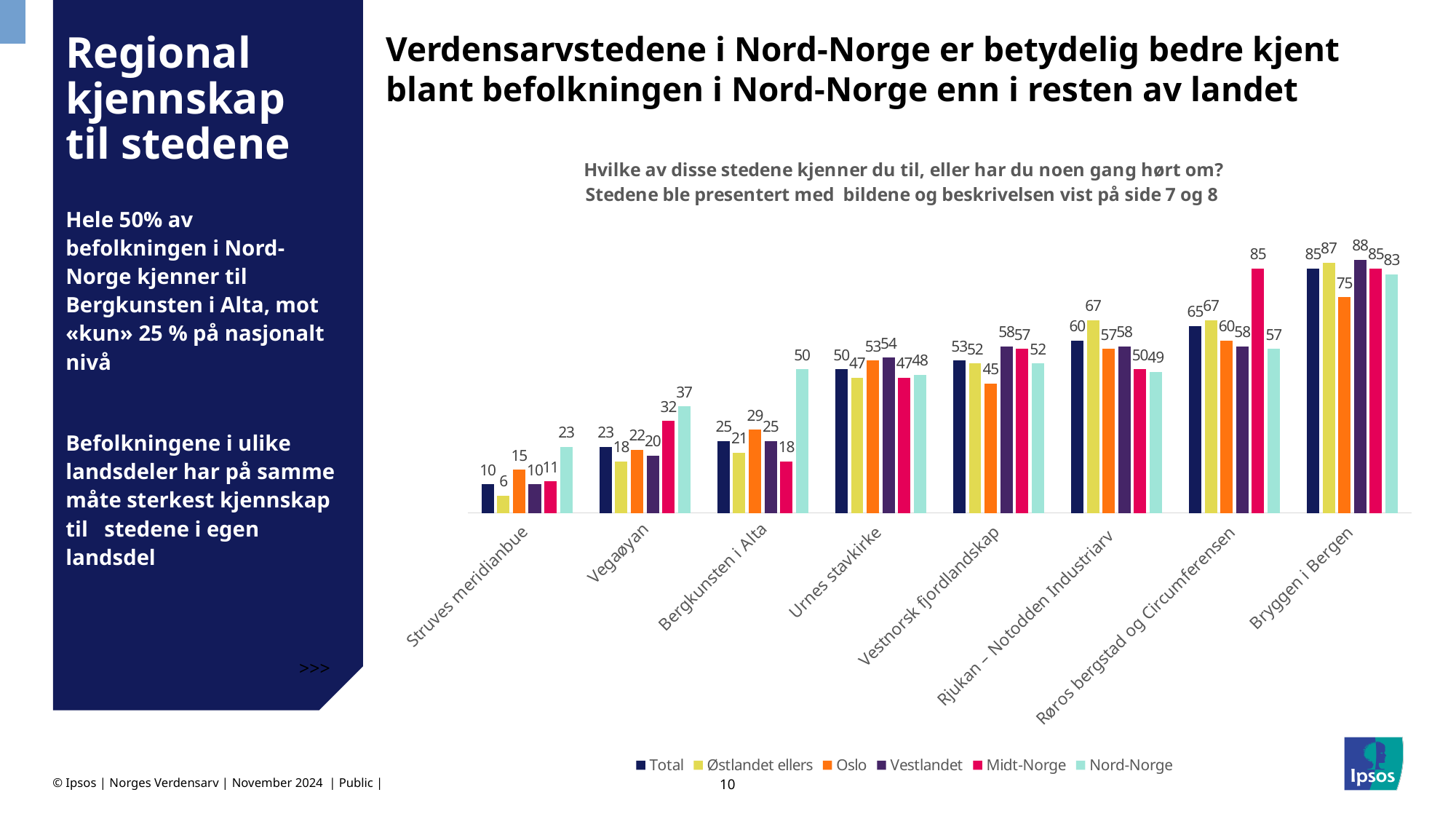
How many categories are shown on the x axis? 8 What is the Østlandet ellers value for Struves meridianbue? 6 What is the difference between the Nord-Norge and Total values for Bergkunsten i Alta? 25 Which category has the highest Total value? Bryggen i Bergen What is the Midt-Norge value for Røros bergstad og Circumferensen? 85 What is the Nord-Norge value for Bergkunsten i Alta? 50 Which is larger for Vegaøyan: the Midt-Norge value or the Oslo value? Midt-Norge What kind of chart is shown on the slide? Bar chart What is the Total value for Bryggen i Bergen? 85 Do the Total values rise or fall from Struves meridianbue to Bryggen i Bergen? Rise Which category has the lowest Nord-Norge value? Struves meridianbue How many series does the legend list? 6